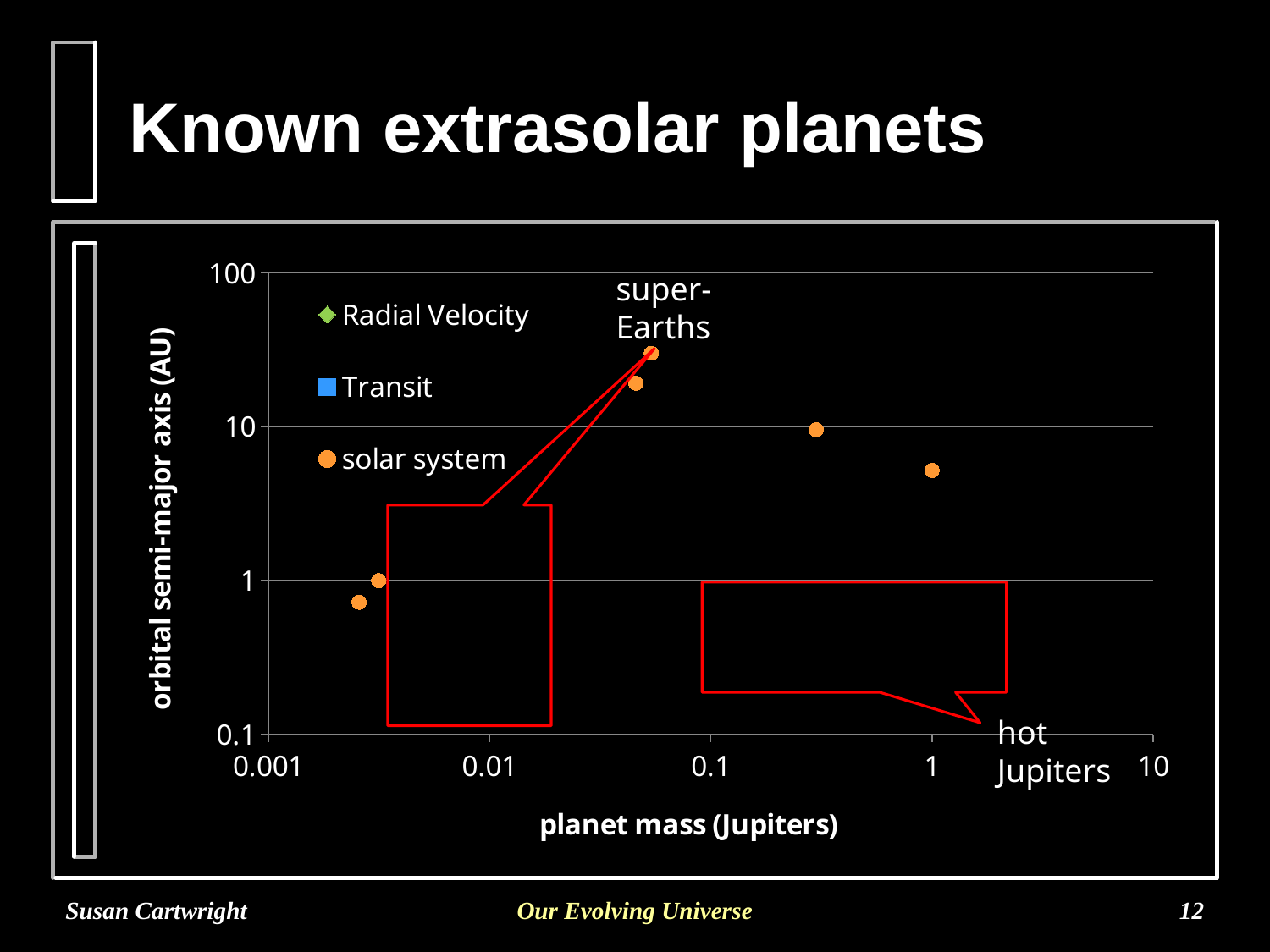
Is the orbital semi-major axis of the highest solar system point greater or less than 10? greater Is the orbital semi-major axis of the solar system point at planet mass 1 greater or less than 1? greater Is the orbital semi-major axis of the solar system point at planet mass 1 greater or less than 10? less How many orange 'solar system' points are plotted on the chart? 6 What is the title of the x axis? planet mass (Jupiters) How many series does the legend list? 3 What are the three series named in the legend? Radial Velocity, Transit, solar system Which has the larger orbital semi-major axis: the solar system point at planet mass 1 or the point near planet mass 0.3? the point near planet mass 0.3 What kind of chart is shown on the slide? scatter chart